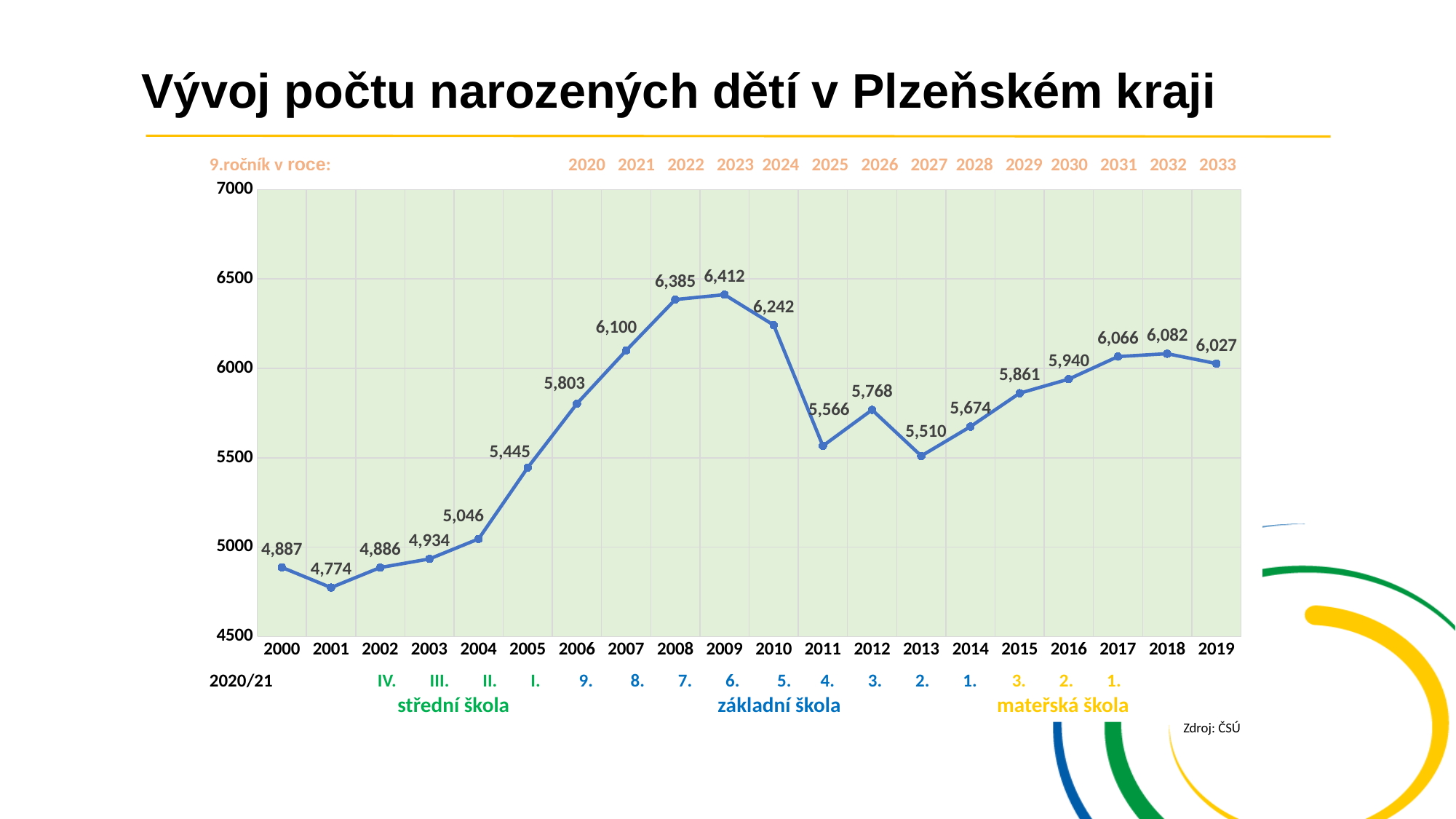
What is the value for 2013? 5,510 Do the values rise or fall from 2004 to 2009? rise Which year has the larger value, 2017 or 2018? 2018 What type of chart is shown on the slide? line chart What is the title of the chart? Vývoj počtu narozených dětí v Plzeňském kraji What is the value for 2001? 4,774 Which year has the highest value? 2009 What is the value for 2009? 6,412 What is the difference between the values for 2010 and 2011? 676 How many years are plotted on the x axis? 20 Which year has the lowest value? 2001 What is the difference between the values for 2019 and 2000? 1,140